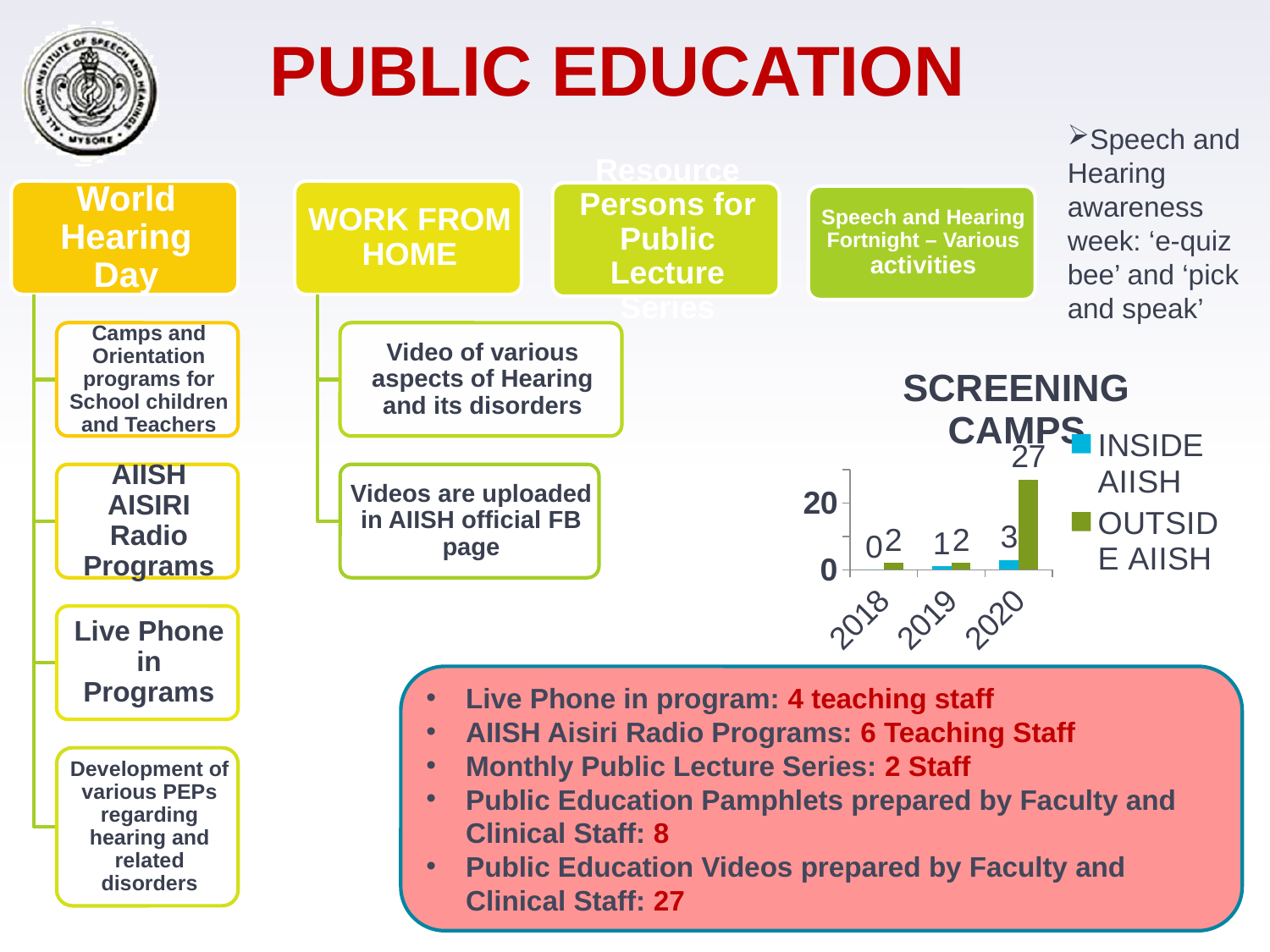
How many years are shown on the x axis of the SCREENING CAMPS chart? 3 In the SCREENING CAMPS chart, what is the value for INSIDE AIISH in 2019? 1 In the SCREENING CAMPS chart, is the value for OUTSIDE AIISH in 2020 greater or less than 20? greater In the SCREENING CAMPS chart, what is the value for OUTSIDE AIISH in 2020? 27 In the SCREENING CAMPS chart, what is the difference between OUTSIDE AIISH and INSIDE AIISH in 2020? 24 In the SCREENING CAMPS chart, do the INSIDE AIISH values rise or fall from 2018 to 2020? rise In the SCREENING CAMPS chart, what is the value for INSIDE AIISH in 2018? 0 In the SCREENING CAMPS chart, what is the value for OUTSIDE AIISH in 2019? 2 In the SCREENING CAMPS chart, which is larger in 2020: INSIDE AIISH or OUTSIDE AIISH? OUTSIDE AIISH What kind of chart is the SCREENING CAMPS chart? bar chart How many series does the legend of the SCREENING CAMPS chart list? 2 In the SCREENING CAMPS chart, which year has the highest value for OUTSIDE AIISH? 2020